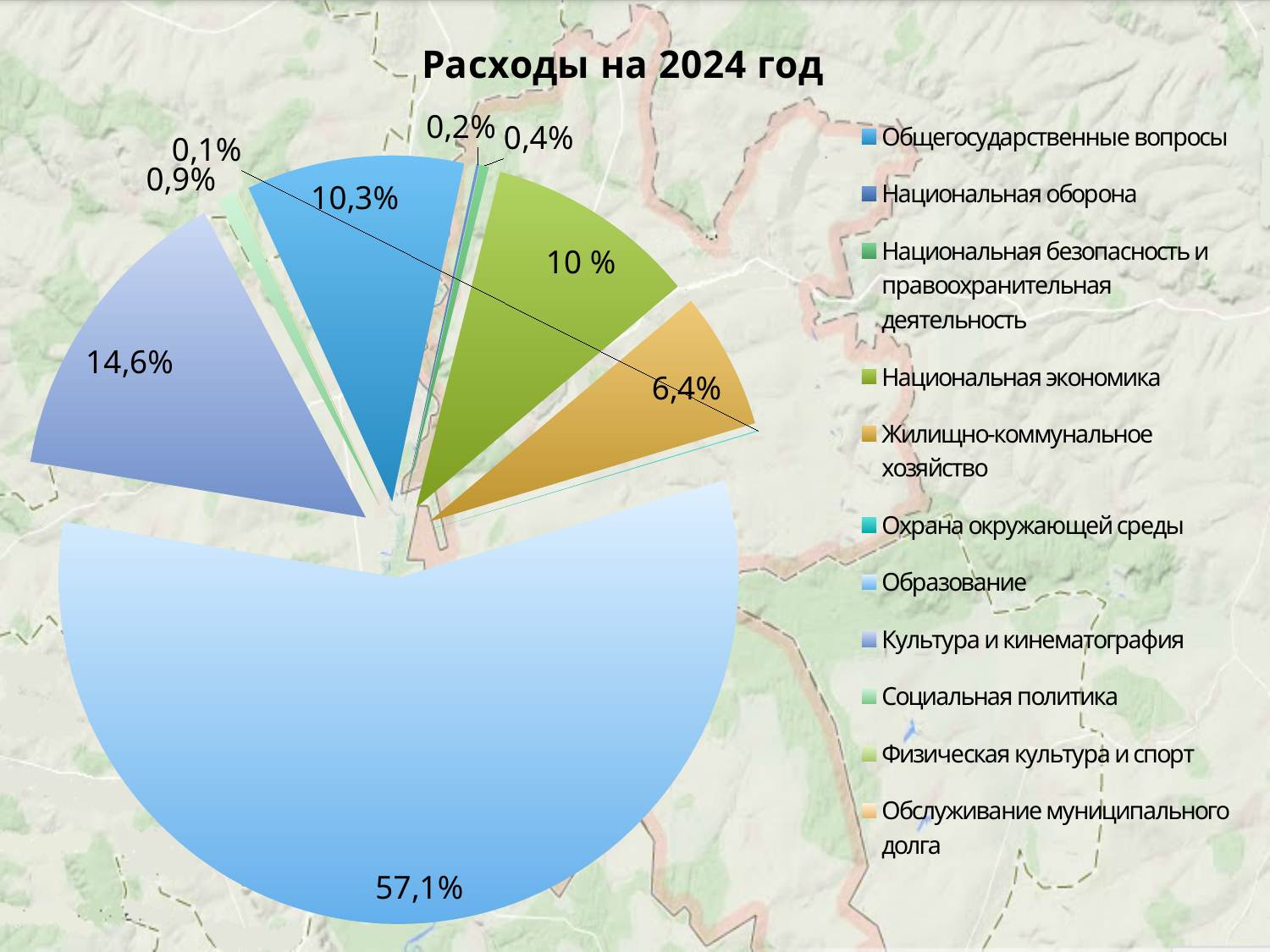
What share of the pie does Национальная экономика have? 10 % What share of the pie does Жилищно-коммунальное хозяйство have? 6,4% What type of chart is shown on the slide? Pie chart What share of the pie does Образование have? 57,1% Which is larger: the share for Общегосударственные вопросы or the share for Национальная экономика? Общегосударственные вопросы What is the title of the chart? Расходы на 2024 год How many categories does the legend list? 11 What is the difference in percentage points between the share for Образование and the share for Культура и кинематография? 42,5 What is the smallest percentage labelled on the chart? 0,1% Which category has the largest share of the pie? Образование